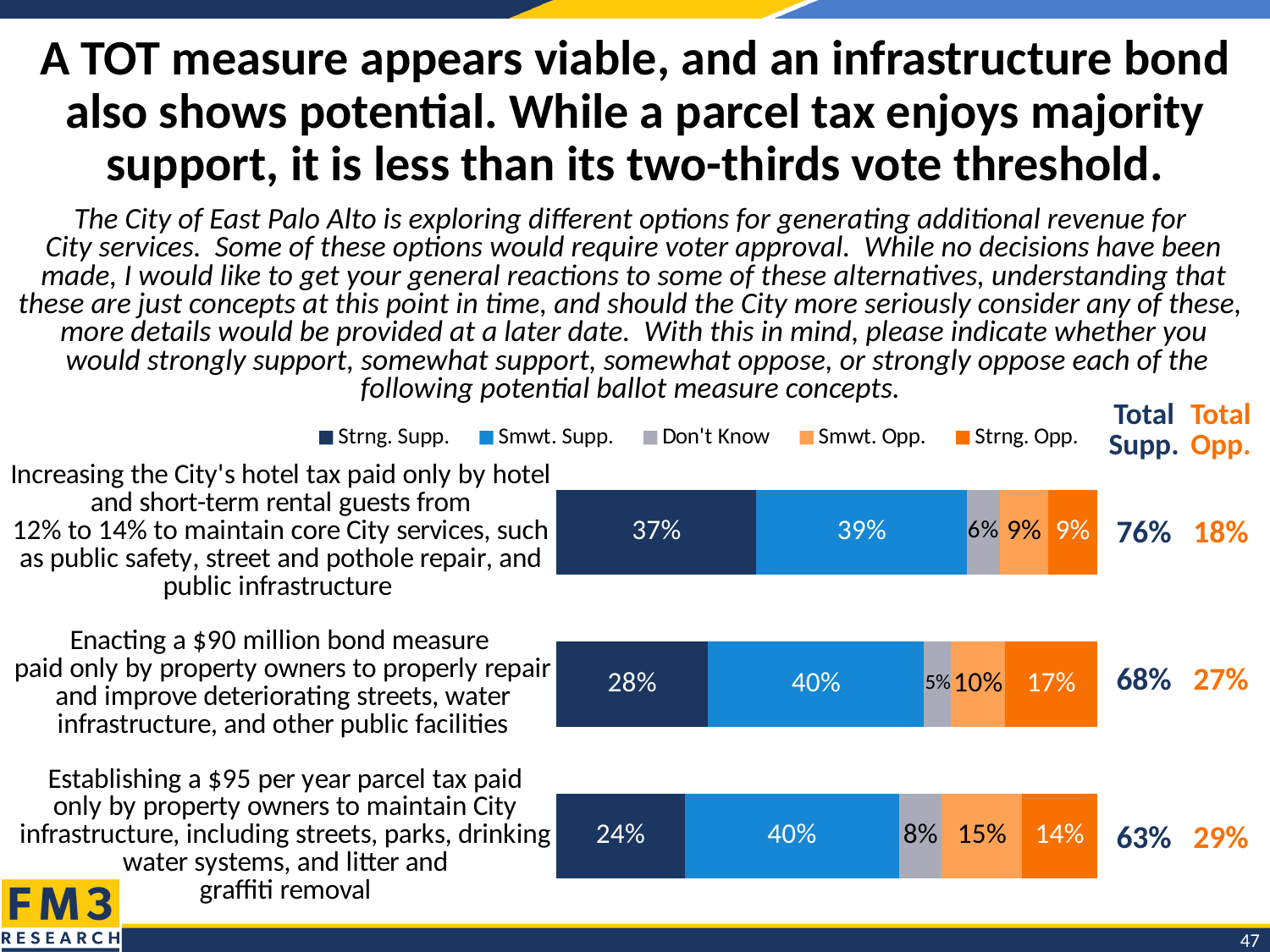
How many series does the legend list? 5 What percentage strongly support increasing the City's hotel tax from 12% to 14%? 37% Which measure has the highest Total Supp. value? Increasing the City's hotel tax What is the combined Strng. Supp. and Smwt. Supp. percentage for the parcel tax? 64% What is the difference between the Strng. Supp. percentage for the hotel tax and for the parcel tax? 13% What percentage somewhat oppose the $90 million bond measure? 10% Is the Strng. Opp. percentage larger for the bond measure or for the hotel tax? Bond measure What kind of chart is shown on the slide? Stacked bar chart Which measure has the lowest Strng. Supp. percentage? Establishing a $95 per year parcel tax What is the Total Supp. value for the $90 million bond measure? 68% What percentage strongly oppose the $95 per year parcel tax? 14% How many ballot measure concepts are plotted in the chart? 3